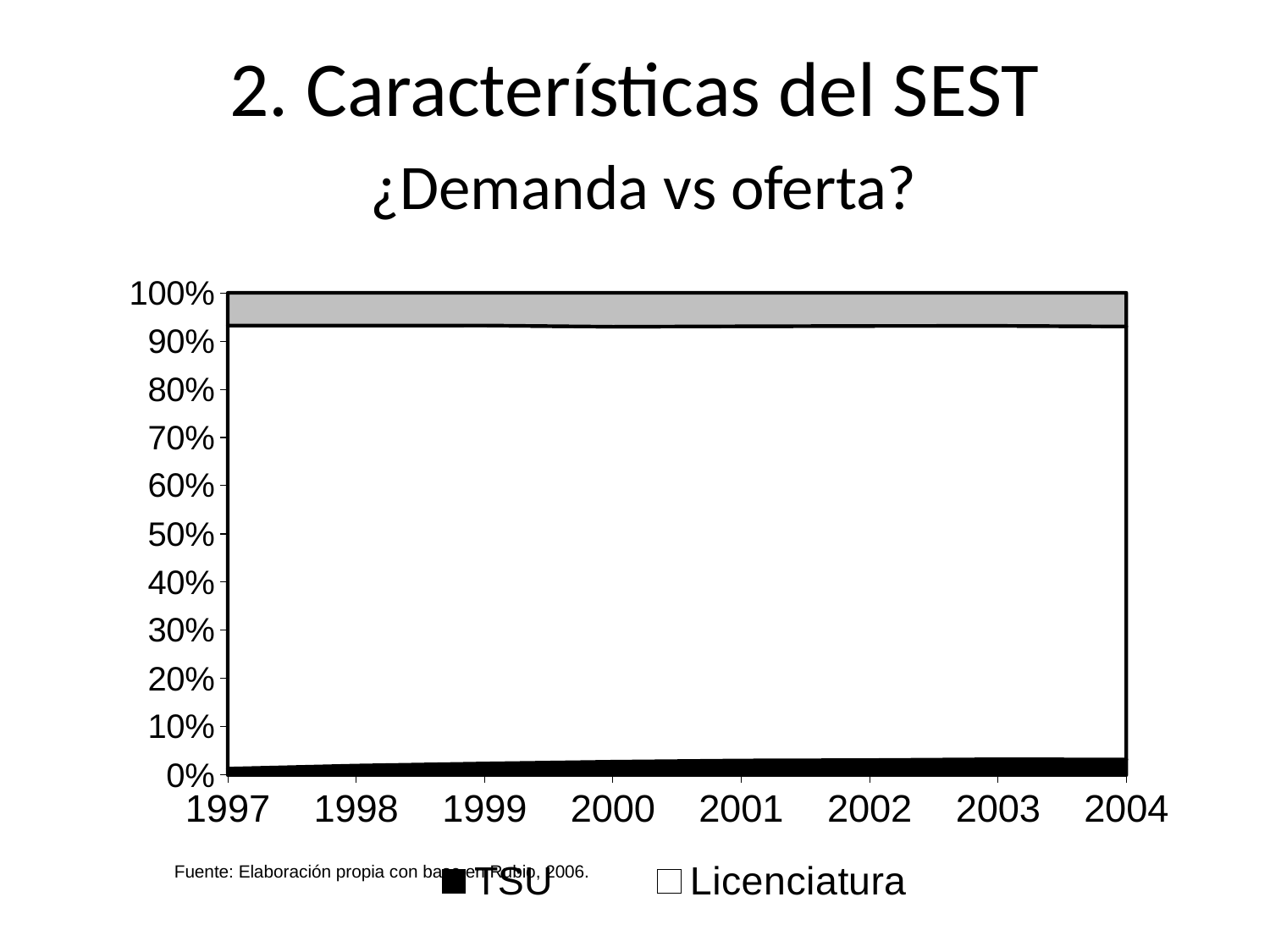
Is the Licenciatura share in 2000 greater or less than 80%? greater Which series occupies the largest share of the chart in 1997? Licenciatura What kind of chart is shown on the slide? Stacked area chart Is the TSU share in 1997 greater or less than 10%? less How many series does the chart's legend list? 2 Is the TSU share in 2004 greater or less than 10%? less What is the last year shown on the x axis of the chart? 2004 What are the two series named in the chart's legend? TSU and Licenciatura Which series has the larger share in 2004, TSU or Licenciatura? Licenciatura What is the first year shown on the x axis of the chart? 1997 Does the TSU share rise or fall from 1997 to 2004? Rise How many years are shown along the x axis of the chart? 8